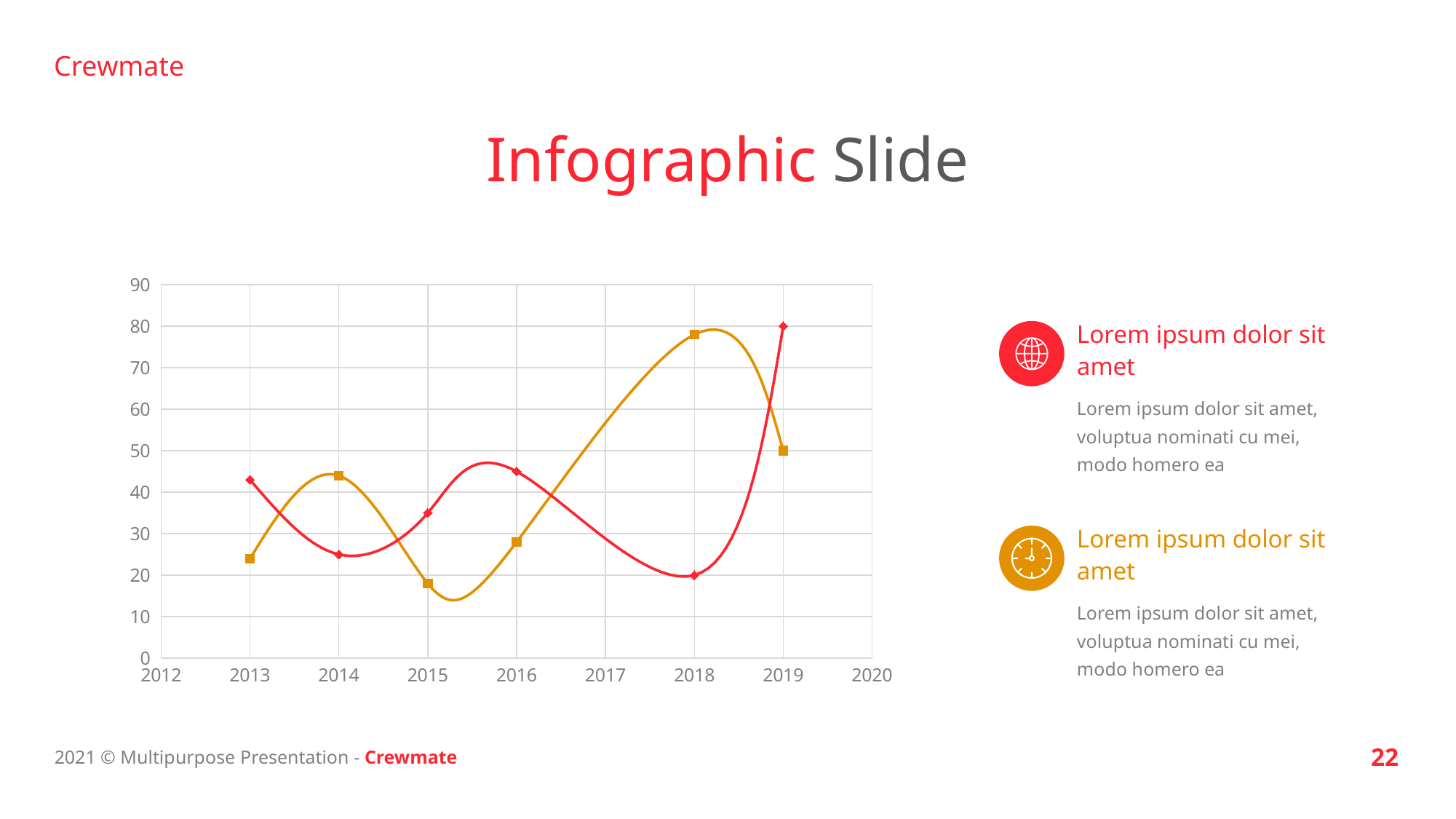
In 2019, which line has the larger value, the red line or the orange line? red line How many data points does the red line have? 6 Is the value of the red line in 2013 greater or less than 40? greater In 2014, which line has the larger value, the red line or the orange line? orange line Is the value of the orange line in 2018 greater or less than 70? greater What is the value of the red line in 2019? 80 Is the value of the orange line in 2015 greater or less than 20? less Which year has the highest value on the red line? 2019 How many data series are plotted on the chart? 2 Which year has the highest value on the orange line? 2018 Which year has the lowest value on the orange line? 2015 What type of chart is shown on the slide? line chart